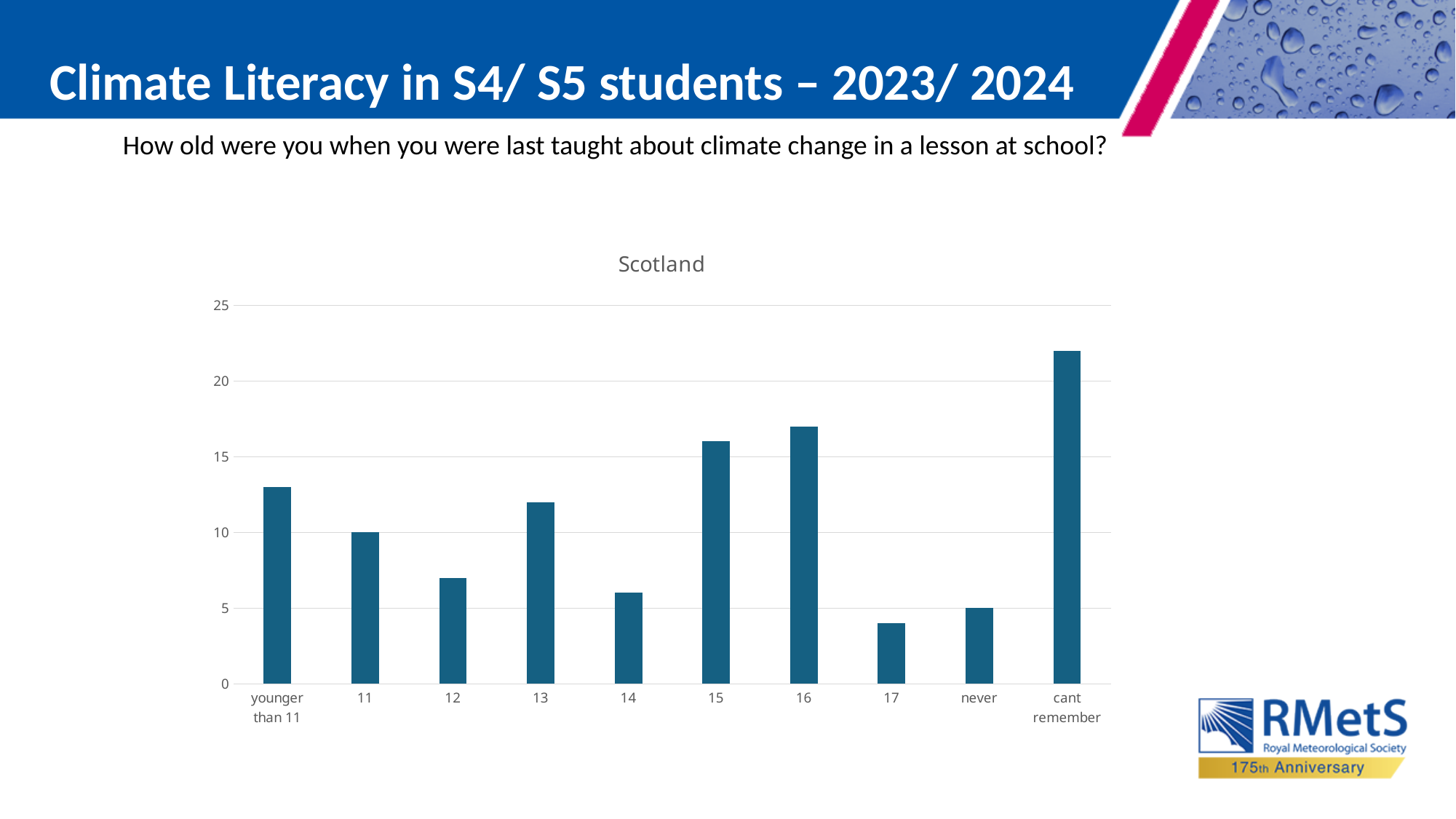
What is the value for the category 11? 10 Is the value for cant remember greater or less than 20? greater What is the title of the chart? Scotland How many categories are shown on the x axis of the chart? 10 Which has the larger value, 15 or 14? 15 Which category has the highest bar? cant remember Which category has the lowest bar? 17 Is the value for 14 greater or less than 10? less Which has the larger value, 13 or 12? 13 Is the value for younger than 11 greater or less than 10? greater What kind of chart is shown on the slide? bar chart What is the value for the category never? 5